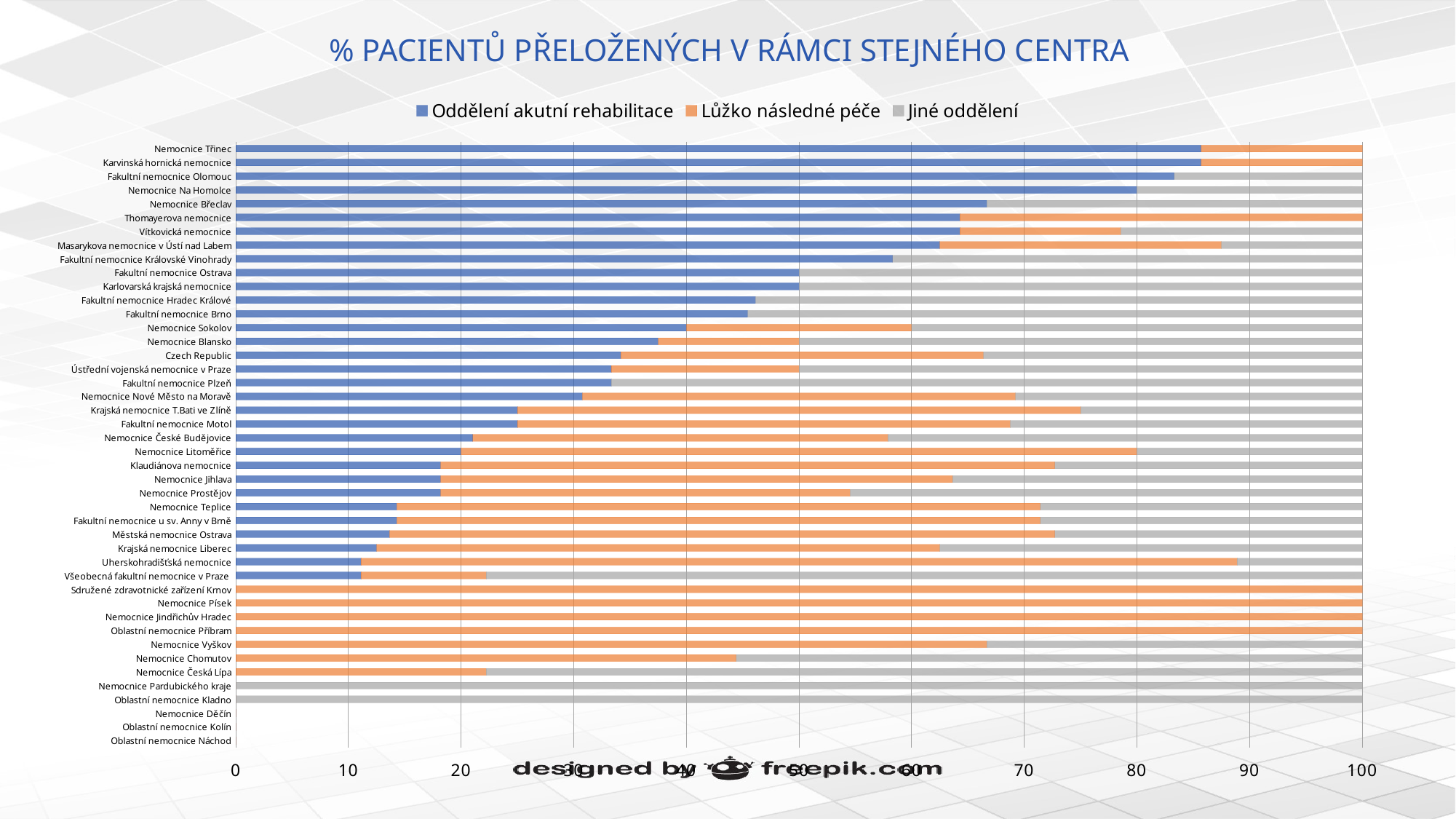
How many series does the legend list? 3 Which has a larger value for Oddělení akutní rehabilitace, Nemocnice Břeclav or Fakultní nemocnice Brno? Nemocnice Břeclav What type of chart is shown on the slide? Stacked bar chart Which series is shown in orange in the legend? Lůžko následné péče What is the value of Lůžko následné péče for Nemocnice Písek? 100 Is the value of Oddělení akutní rehabilitace for Nemocnice Břeclav greater or less than 60? greater What is the total of the stacked bar for Nemocnice Třinec? 100 Is the value of Oddělení akutní rehabilitace for Nemocnice Jihlava greater or less than 20? less What is the title of the chart? % PACIENTŮ PŘELOŽENÝCH V RÁMCI STEJNÉHO CENTRA Is the value of Oddělení akutní rehabilitace for Nemocnice Třinec greater or less than 80? greater How many hospitals (categories) are listed on the vertical axis? 44 What is the value of Jiné oddělení for Oblastní nemocnice Kladno? 100